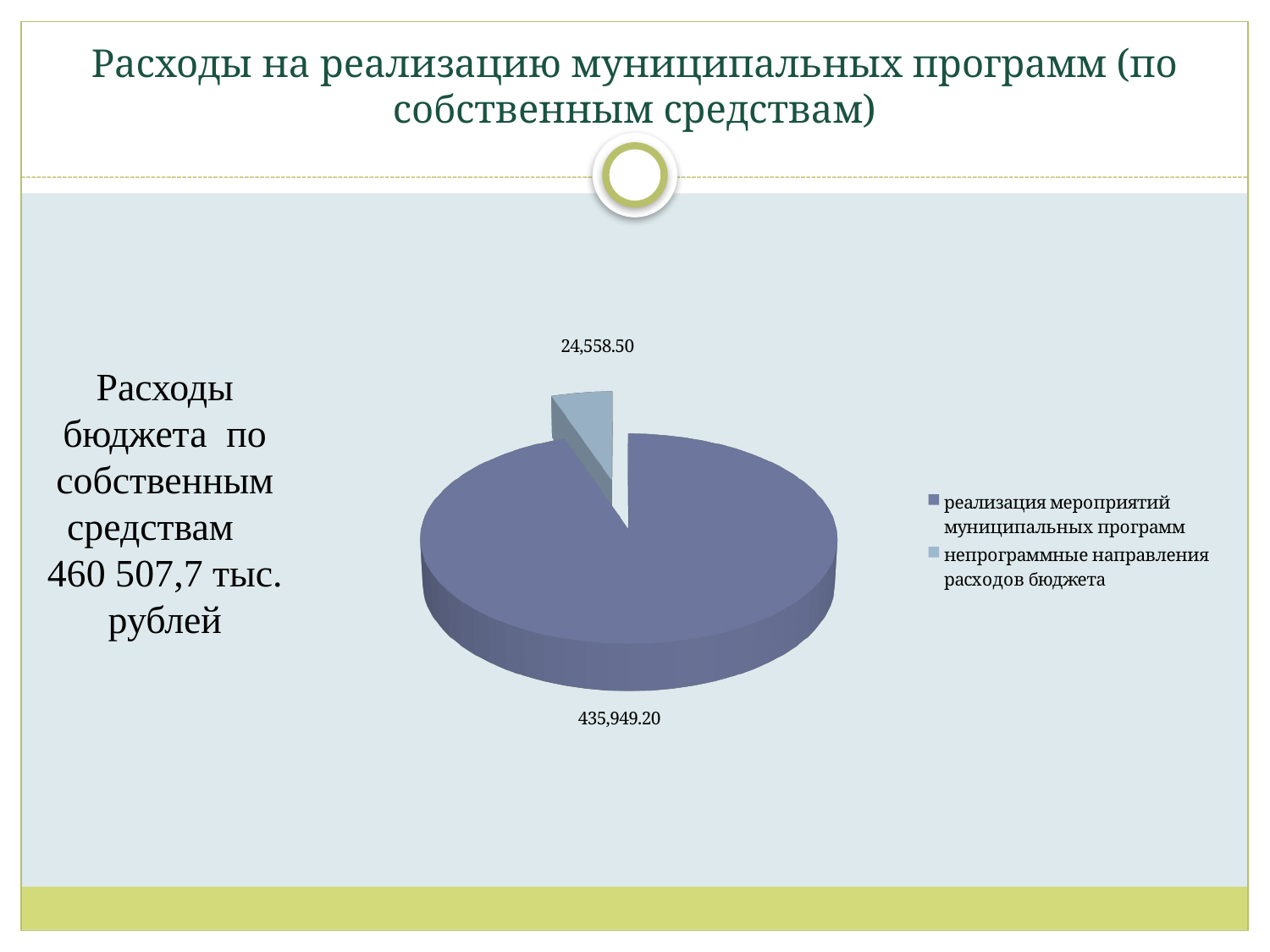
Which category has the largest slice of the pie? реализация мероприятий муниципальных программ What is the title of the slide containing the chart? Расходы на реализацию муниципальных программ (по собственным средствам) Which is larger: the value for "реализация мероприятий муниципальных программ" or the value for "непрограммные направления расходов бюджета"? реализация мероприятий муниципальных программ What is the value for "непрограммные направления расходов бюджета"? 24,558.50 How many slices does the pie chart have? 2 Which category has the smallest slice of the pie? непрограммные направления расходов бюджета What is the total of the two values shown on the pie chart? 460,507.70 What type of chart is shown on the slide? Pie chart How many entries does the legend list? 2 What is the value for "реализация мероприятий муниципальных программ"? 435,949.20 What is the difference between the value for "реализация мероприятий муниципальных программ" and the value for "непрограммные направления расходов бюджета"? 411,390.70 What share of the pie does "непрограммные направления расходов бюджета" represent, to the nearest whole percent? 5%